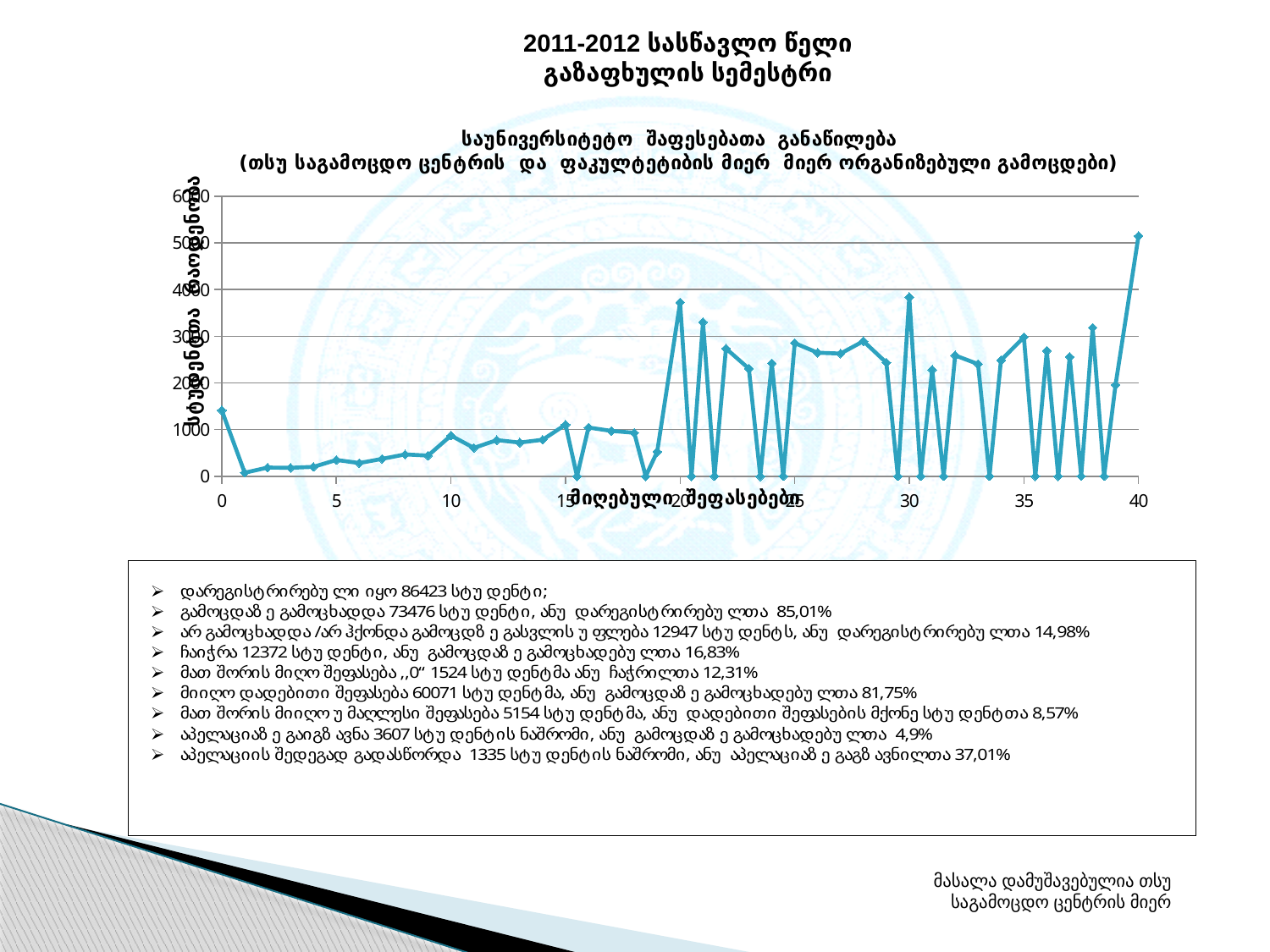
Is the value at x = 20 greater or less than 3000? greater Which is larger, the value at x = 40 or the value at x = 0? x = 40 Is the value at x = 25 greater or less than 2000? greater Is the value at x = 5 greater or less than 1000? less Which is larger, the value at x = 10 or the value at x = 20? x = 20 What kind of chart is shown on the slide? line chart What is the highest value shown on the y axis? 6000 At which x-axis value does the line reach its highest point? 40 What is the label of the x axis? მიღებული შეფასებები